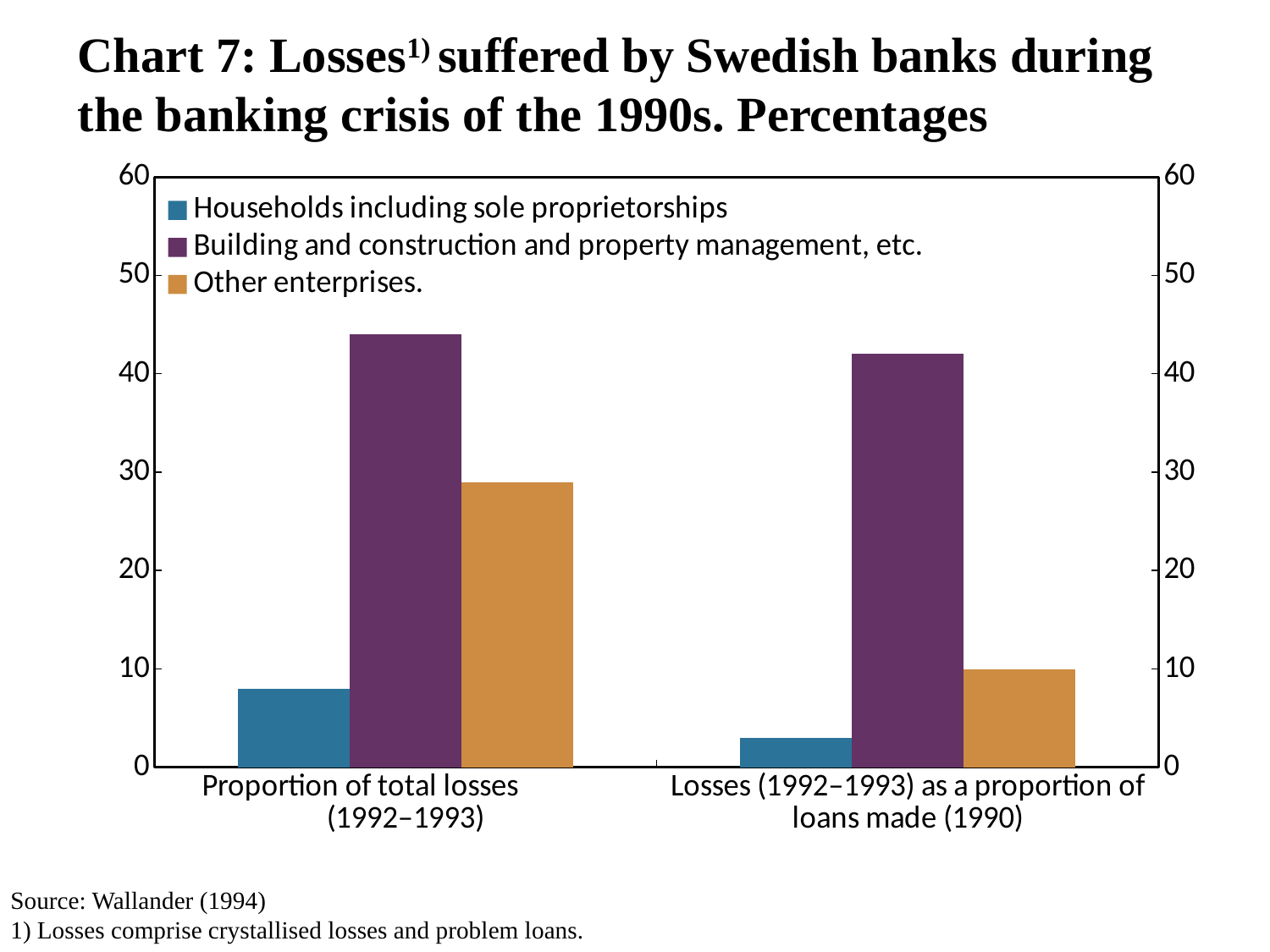
What is the source cited below the chart? Wallander (1994) Is the value for 'Other enterprises.' in the 'Losses (1992–1993) as a proportion of loans made (1990)' category greater or less than 20? less What type of chart is shown on the slide? bar chart How many categories are shown on the x axis? 2 Which series has the highest value in the 'Proportion of total losses (1992–1993)' category? Building and construction and property management, etc. How many series does the legend list? 3 Is the value for 'Building and construction and property management, etc.' in the 'Proportion of total losses (1992–1993)' category greater or less than 40? greater Is the value for 'Households including sole proprietorships' in the 'Proportion of total losses (1992–1993)' category greater or less than 10? less Which series has the lowest value in the 'Losses (1992–1993) as a proportion of loans made (1990)' category? Households including sole proprietorships Which is larger for 'Other enterprises.': the value in 'Proportion of total losses (1992–1993)' or in 'Losses (1992–1993) as a proportion of loans made (1990)'? Proportion of total losses (1992–1993) Which is larger for 'Households including sole proprietorships': the value in 'Proportion of total losses (1992–1993)' or in 'Losses (1992–1993) as a proportion of loans made (1990)'? Proportion of total losses (1992–1993)